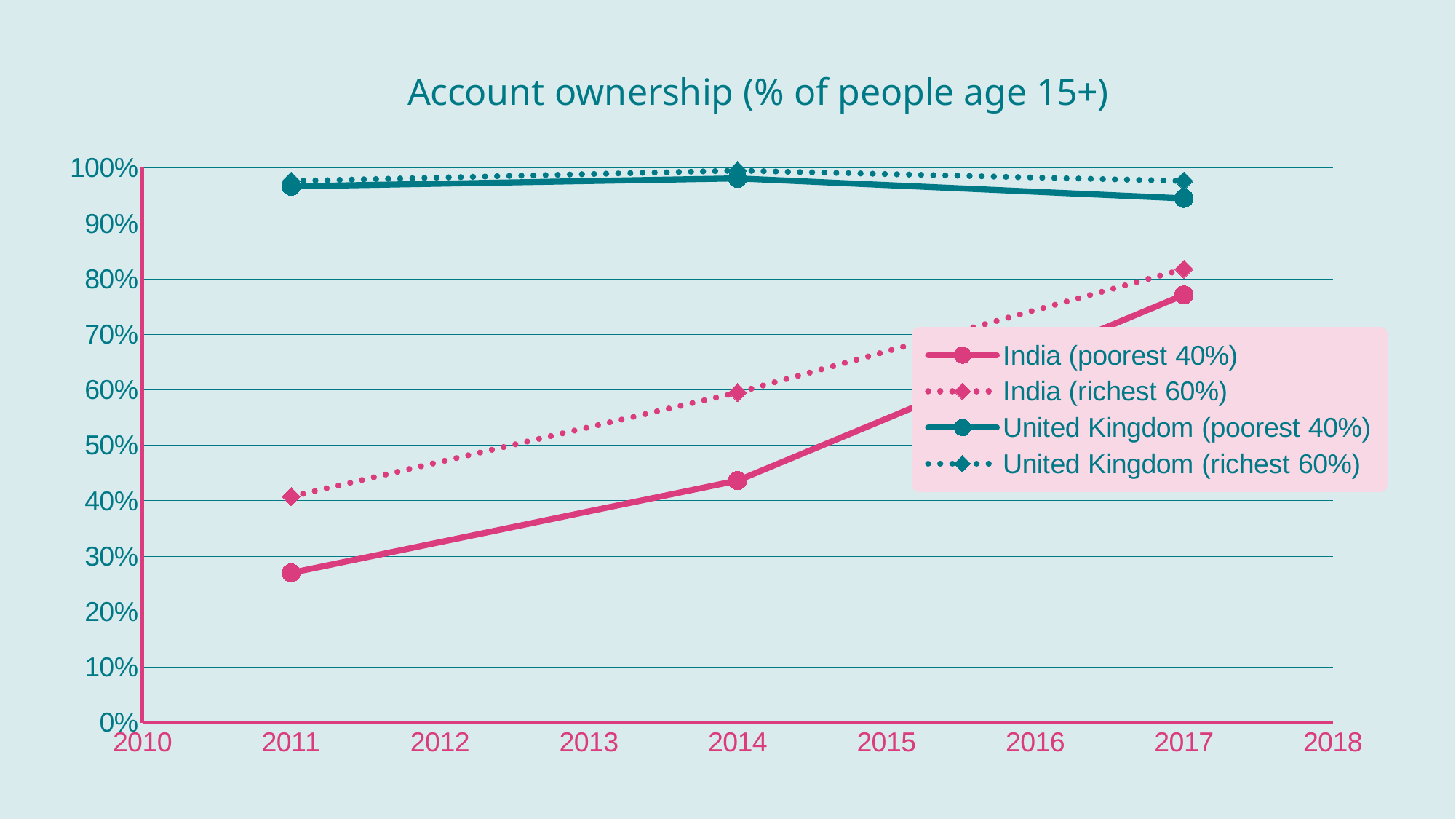
What is the title of the chart? Account ownership (% of people age 15+) Is the value for India (richest 60%) in 2011 greater or less than 50%? less Does the India (poorest 40%) series rise or fall from 2011 to 2017? Rise Is the value for India (poorest 40%) in 2017 greater or less than 70%? greater Is the value for India (richest 60%) in 2014 greater or less than 50%? greater How many series does the legend list? 4 What kind of chart is shown on the slide? Line chart In 2017, which is larger: United Kingdom (richest 60%) or India (richest 60%)? United Kingdom (richest 60%) In 2014, which is larger: India (richest 60%) or India (poorest 40%)? India (richest 60%) How many data points are plotted for the India (poorest 40%) series? 3